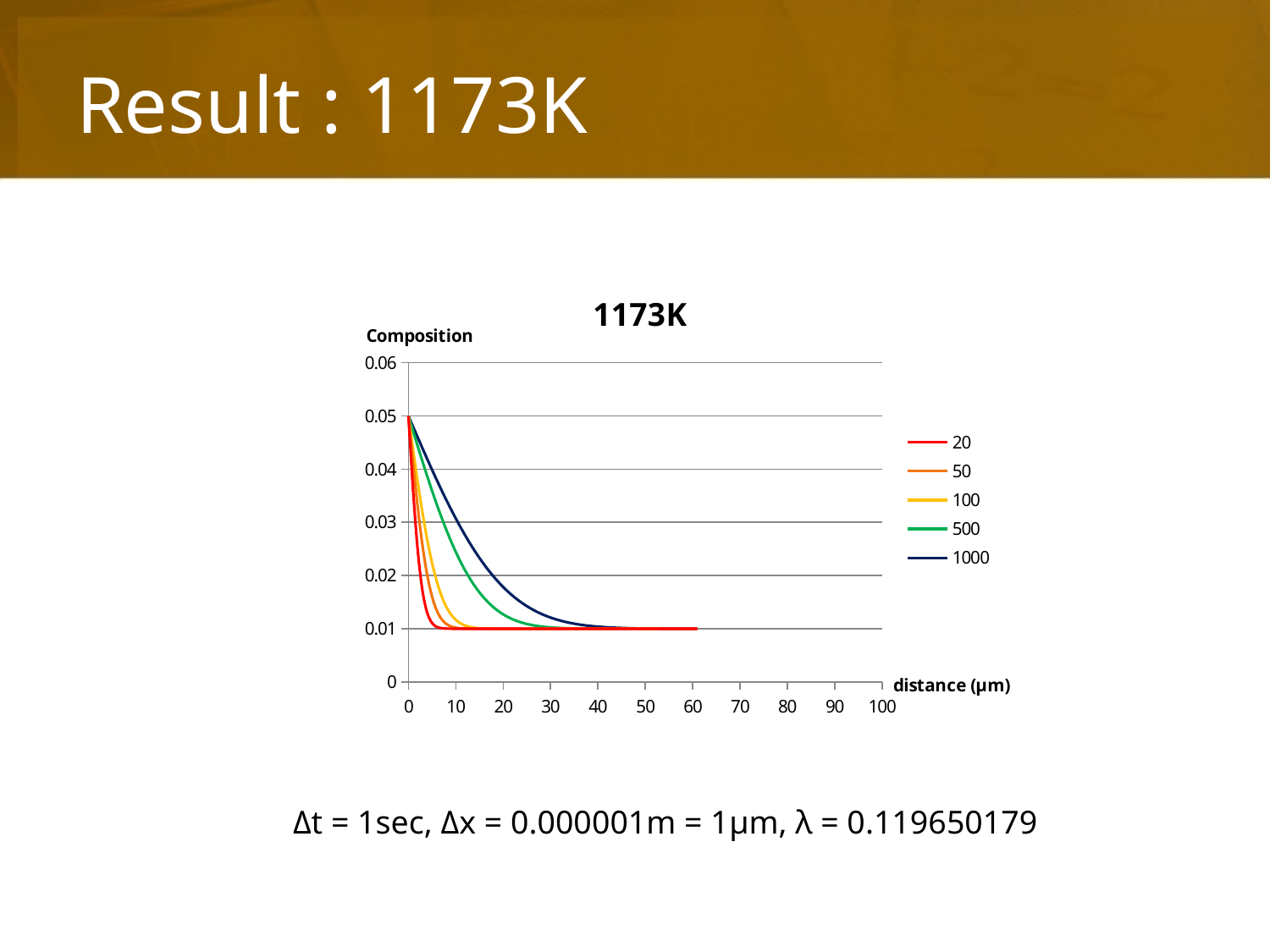
At a distance of 10 μm, which series has the larger composition value, 1000 or 20? 1000 What is the label of the x axis of the chart? distance (μm) At a distance of 20 μm, which series has the highest composition value? 1000 What composition value do all the series start at when distance is 0? 0.05 Do the composition values rise or fall as distance increases along the x axis? fall How many series does the legend of the 1173K chart list? 5 What composition value do the curves level off at for large distances? 0.01 Is the value for the 20 series at a distance of 10 μm greater or less than 0.02? less What is the title of the chart? 1173K What kind of chart is shown on the slide? line chart Is the value for the 500 series at a distance of 40 μm greater or less than 0.02? less